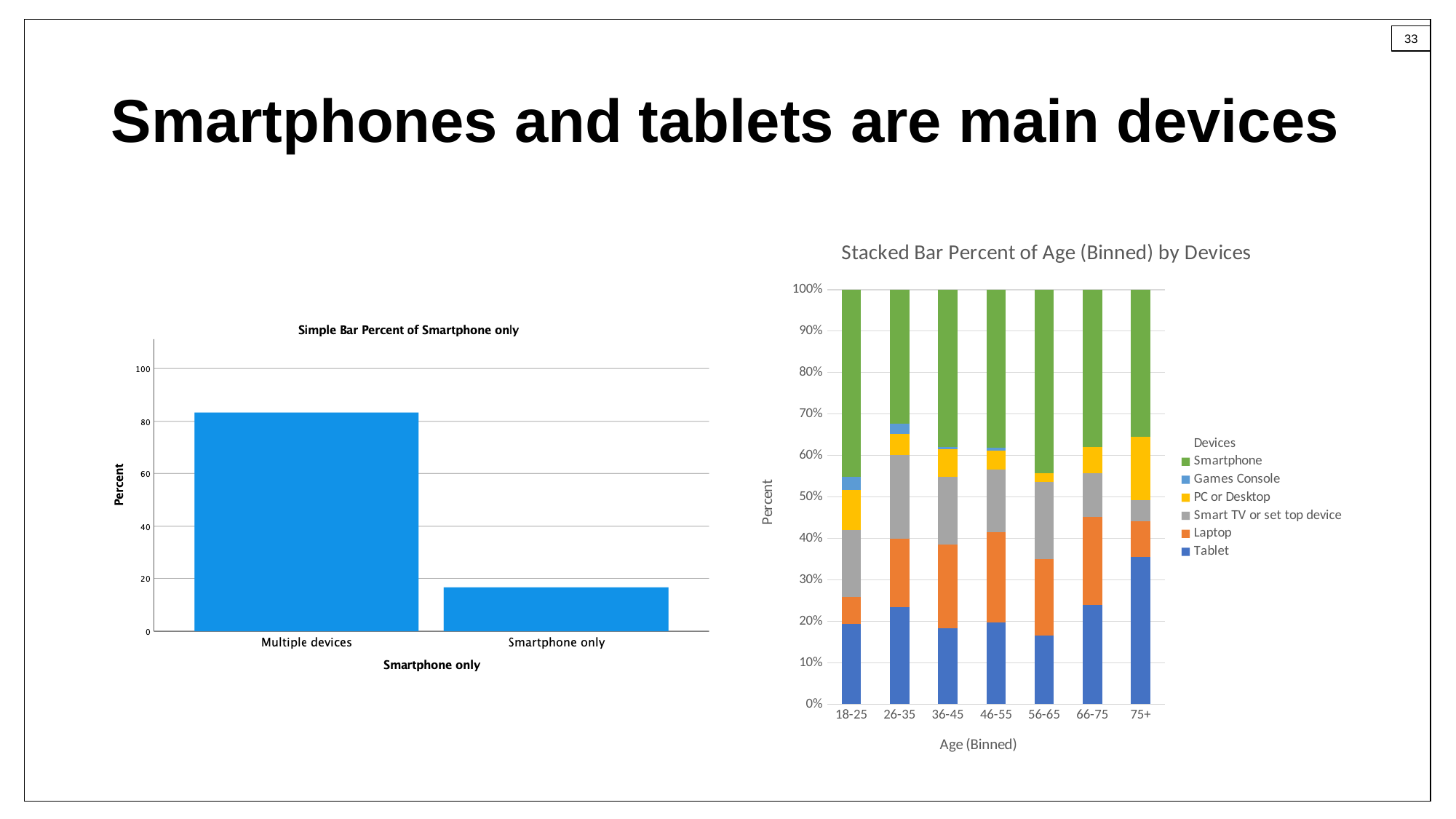
In the chart titled 'Simple Bar Percent of Smartphone only', is the value for Multiple devices greater or less than 80? greater In the chart titled 'Simple Bar Percent of Smartphone only', what kind of chart is shown? bar chart In the chart titled 'Stacked Bar Percent of Age (Binned) by Devices', what is the label of the x axis? Age (Binned) In the chart titled 'Stacked Bar Percent of Age (Binned) by Devices', how many series does the legend list? 6 In the chart titled 'Simple Bar Percent of Smartphone only', which category has the lower bar? Smartphone only In the chart titled 'Stacked Bar Percent of Age (Binned) by Devices', is the Tablet share for the 75+ age group greater or less than 30%? greater In the chart titled 'Simple Bar Percent of Smartphone only', which category has the higher bar? Multiple devices In the chart titled 'Simple Bar Percent of Smartphone only', is the value for Smartphone only greater or less than 20? less In the chart titled 'Stacked Bar Percent of Age (Binned) by Devices', how many age groups are shown on the x axis? 7 In the chart titled 'Simple Bar Percent of Smartphone only', how many categories are shown on the x axis? 2 In the chart titled 'Stacked Bar Percent of Age (Binned) by Devices', which age group has the largest Tablet share? 75+ In the chart titled 'Stacked Bar Percent of Age (Binned) by Devices', which series is shown in green in the legend? Smartphone